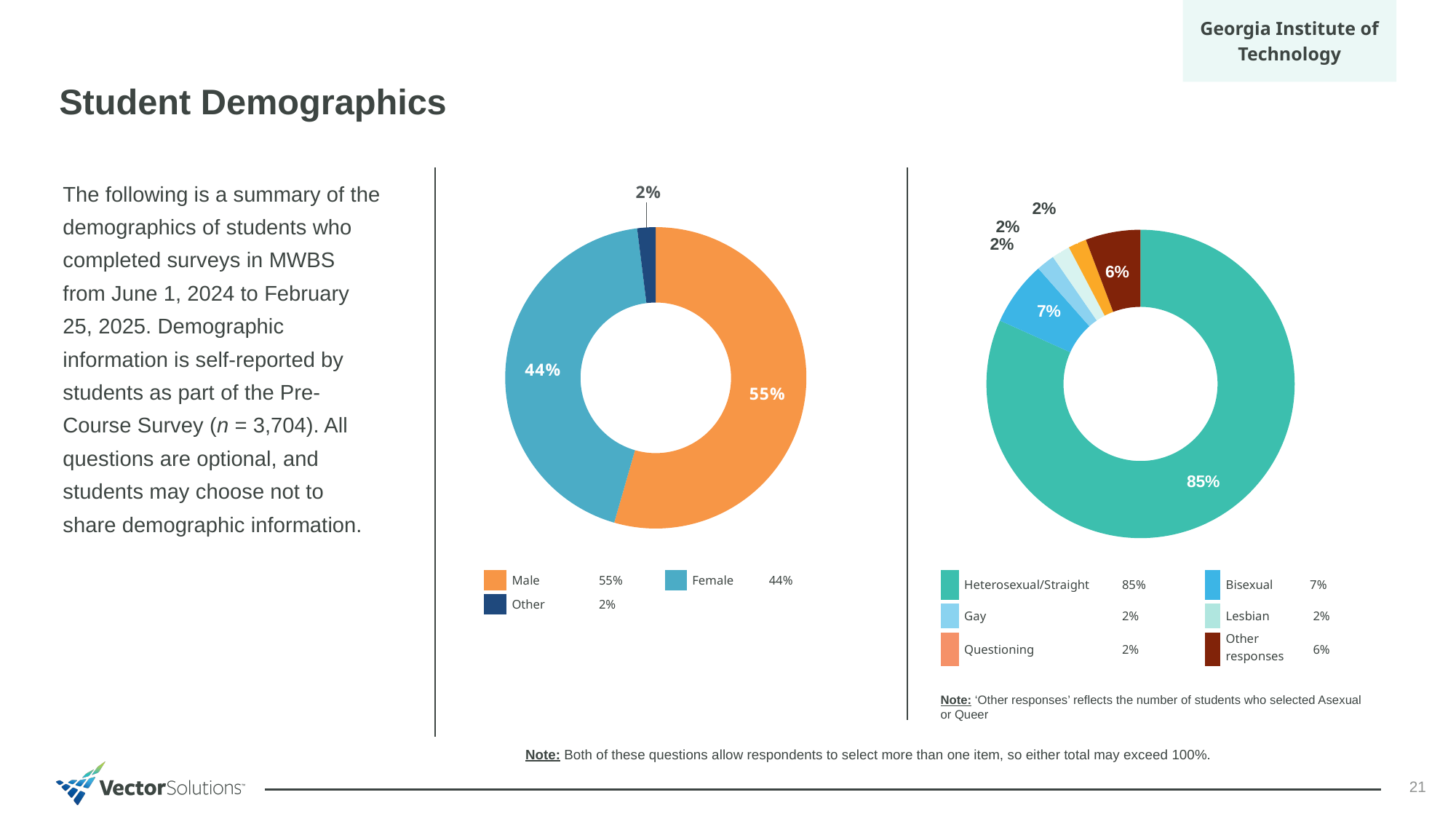
What type of chart is used on this slide? Pie (donut) chart In the right chart (sexual orientation), how many categories does the legend list? 6 In the left chart (gender), what percentage of students are Female? 44% In the right chart (sexual orientation), what percentage of students are Heterosexual/Straight? 85% In the right chart (sexual orientation), which is larger, Bisexual or Other responses? Bisexual In the left chart (gender), what percentage of students selected Other? 2% In the left chart (gender), what percentage of students are Male? 55% In the right chart (sexual orientation), what percentage of students are Bisexual? 7% In the left chart (gender), what is the difference between the Male and Female percentages? 11% In the right chart (sexual orientation), what percentage of students selected Other responses? 6% In the left chart (gender), how many categories does the legend list? 3 In the left chart (gender), which category has the largest share? Male